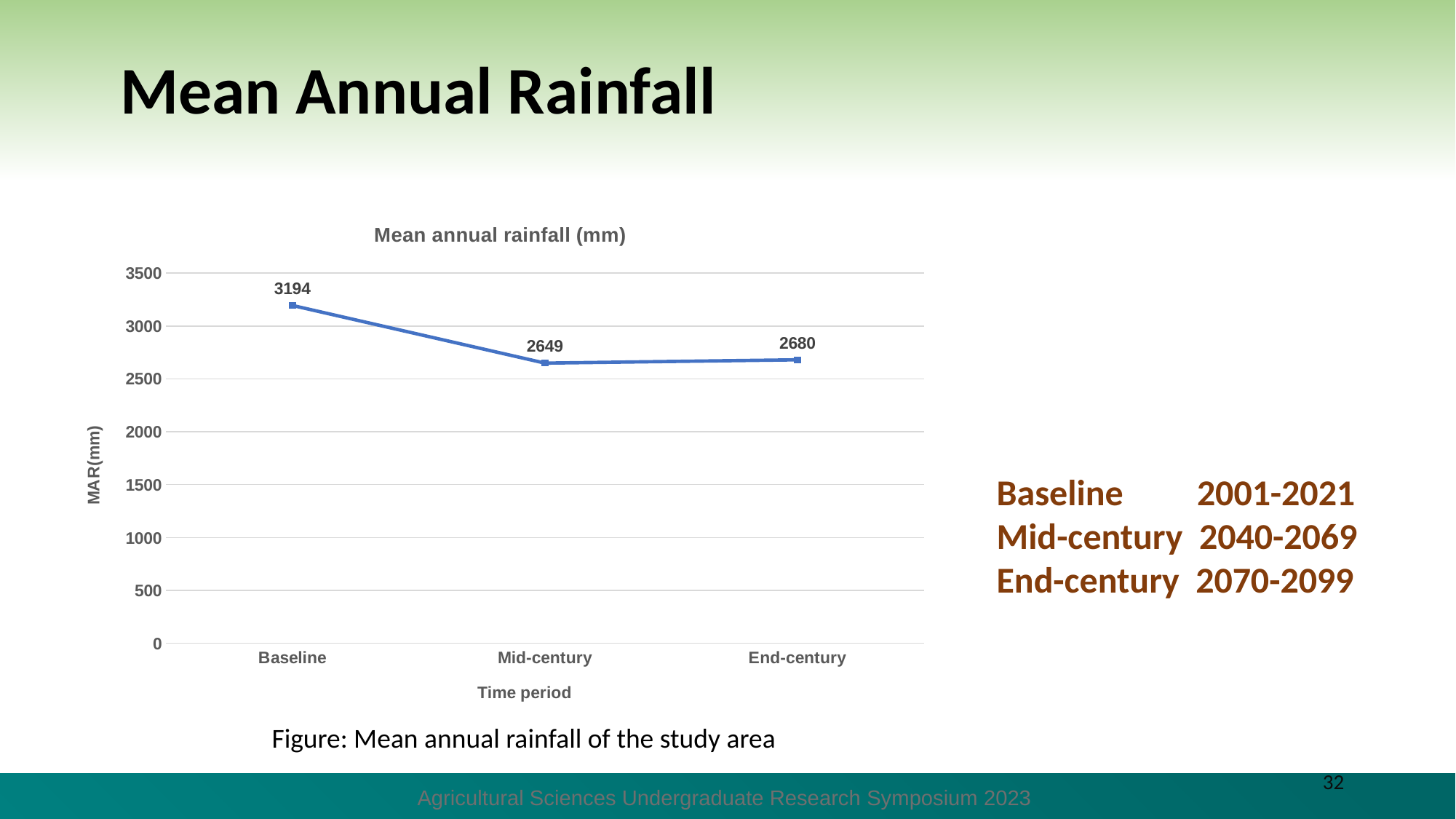
What is the mean annual rainfall value for the Mid-century period? 2649 What is the label of the y-axis on the chart? MAR(mm) How many time periods are plotted on the chart? 3 Which time period has the lowest mean annual rainfall? Mid-century What is the difference in mean annual rainfall between the End-century and Mid-century periods? 31 Is the mean annual rainfall for the Baseline period greater or less than 3000? greater What is the mean annual rainfall value for the End-century period? 2680 Which time period has the highest mean annual rainfall? Baseline What kind of chart is shown on the slide? Line chart What is the difference in mean annual rainfall between the Baseline and Mid-century periods? 545 What is the mean annual rainfall value for the Baseline period? 3194 Which has a larger mean annual rainfall value, Baseline or End-century? Baseline